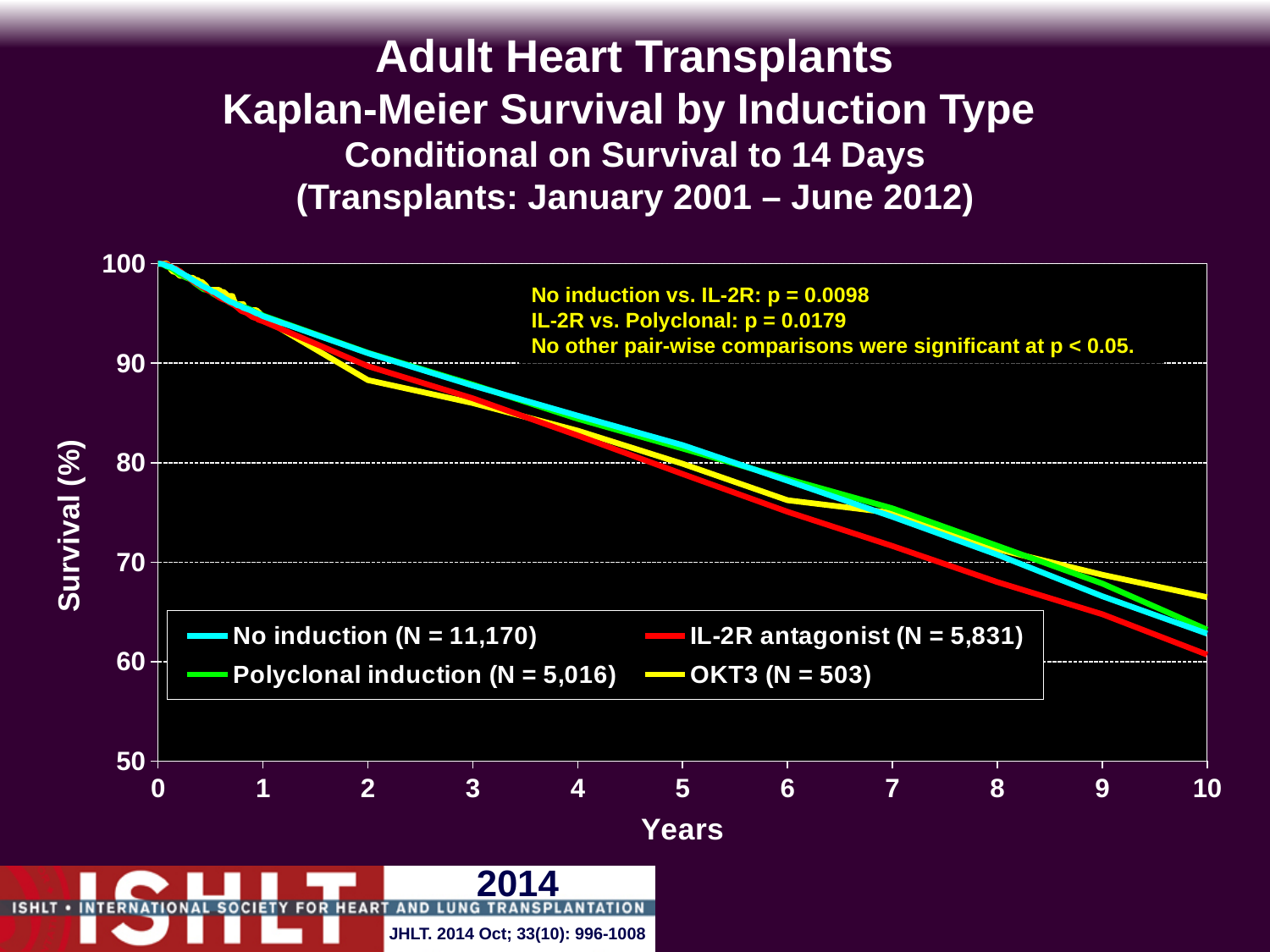
What is the N for the No induction group shown in the legend? 11,170 Which induction group has the lowest survival at year 10? IL-2R antagonist What is the N for the OKT3 group shown in the legend? 503 Is the survival for OKT3 at year 2 greater or less than 90? less Do the survival curves rise or fall as years increase? fall What is the survival (%) for all groups at year 0? 100 Is the survival for IL-2R antagonist at year 8 greater or less than 70? less What kind of chart is shown on the slide? line chart Is the survival for No induction at year 10 greater or less than 60? greater How many series does the legend list? 4 At year 10, is survival higher for OKT3 or for IL-2R antagonist? OKT3